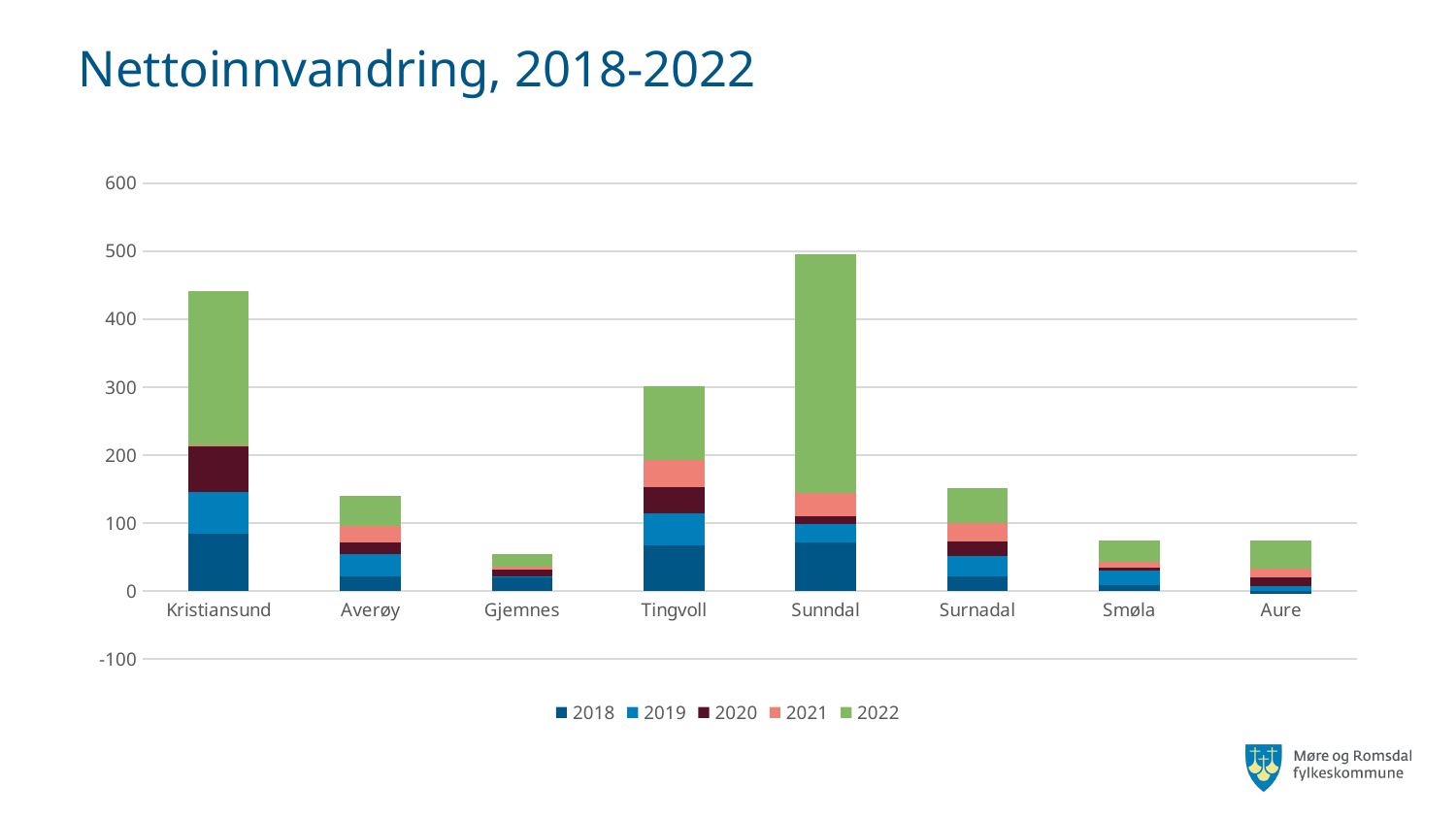
Which has the larger total stacked bar, Kristiansund or Tingvoll? Kristiansund Is the total stacked value for Gjemnes greater or less than 100? less Is the total stacked value for Sunndal greater or less than 400? greater How many series does the legend list? 5 How many municipalities (categories) are shown on the x axis? 8 What kind of chart is shown on the slide? Stacked bar chart What is the title of the chart? Nettoinnvandring, 2018-2022 Which municipality has the highest total stacked bar? Sunndal Is the total stacked value for Averøy greater or less than 200? less Which municipality has the lowest total stacked bar? Gjemnes Which year is represented by the green segments in the legend? 2022